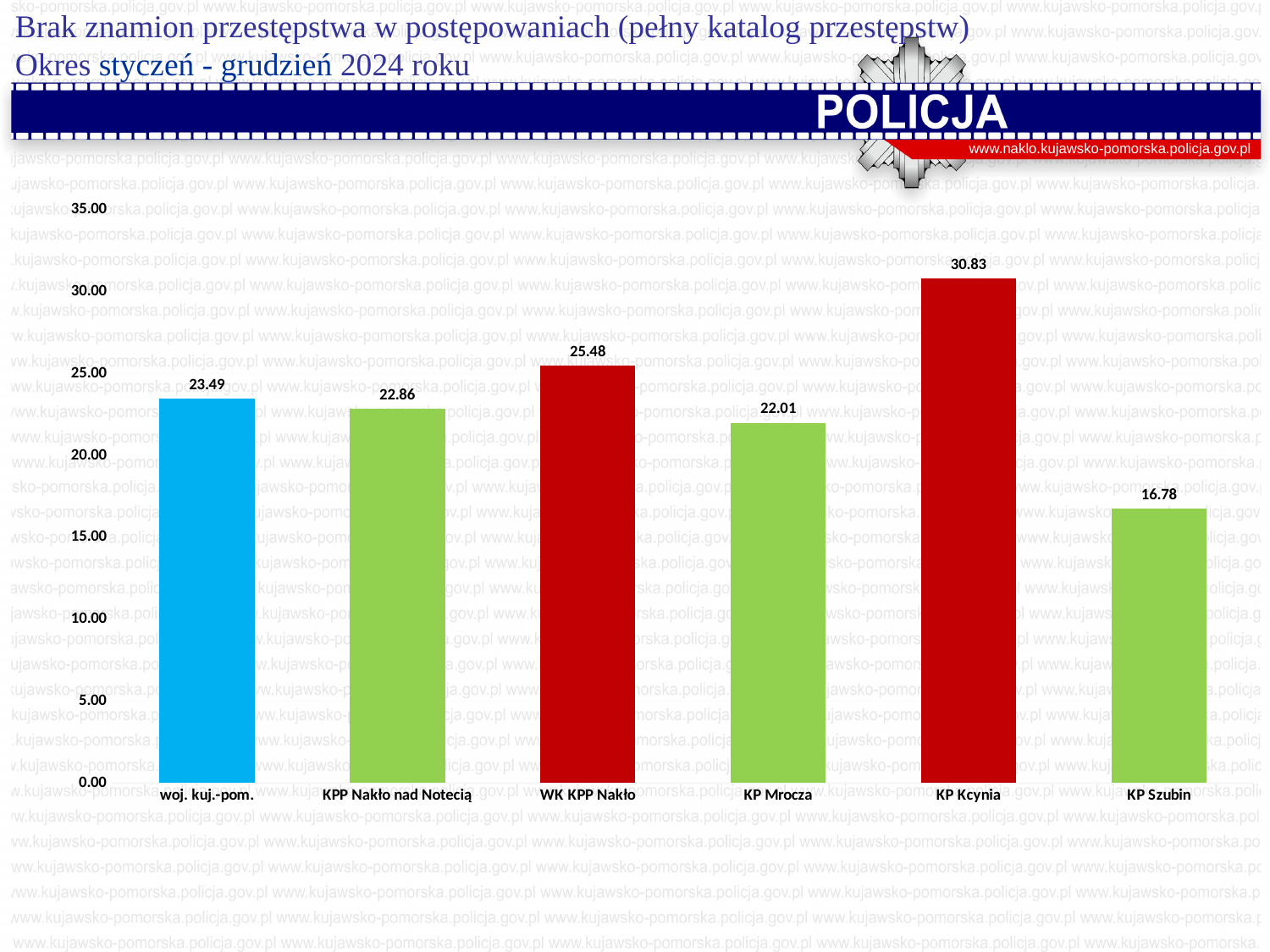
Is the value for KP Kcynia greater or less than 30.00? greater Which is larger, the value for KPP Nakło nad Notecią or the value for KP Mrocza? KPP Nakło nad Notecią What kind of chart is shown on the slide? bar chart Which category has the highest value? KP Kcynia What is the difference between the values for KP Kcynia and KP Szubin? 14.05 What is the difference between the values for WK KPP Nakło and KP Mrocza? 3.47 How many categories are shown on the x axis? 6 What is the value for WK KPP Nakło? 25.48 Which category has the lowest value? KP Szubin What is the value for woj. kuj.-pom.? 23.49 What is the value for KP Szubin? 16.78 What is the value for KP Kcynia? 30.83